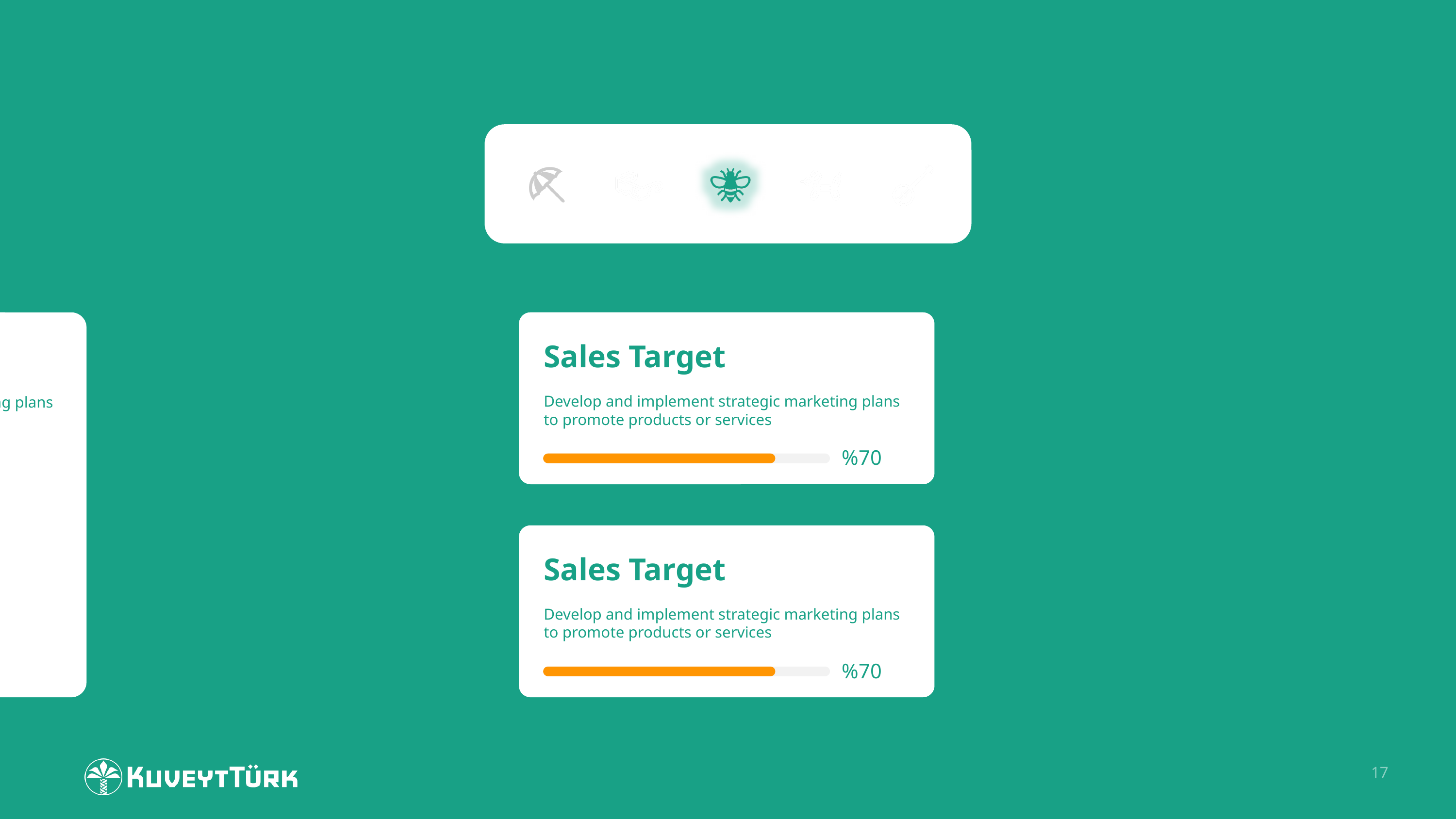
What kind of visual is used to show the Sales Target values? Progress bar What is the title of the card containing the upper progress bar? Sales Target Is the value shown for the lower Sales Target progress bar greater or less than 100? less What value is shown next to the progress bar in the upper Sales Target card? %70 Is the value shown for the upper Sales Target progress bar greater or less than 50? greater What colour is the filled portion of the Sales Target progress bars? Orange What value is shown next to the progress bar in the lower Sales Target card? %70 How many progress bars are shown on the slide? 2